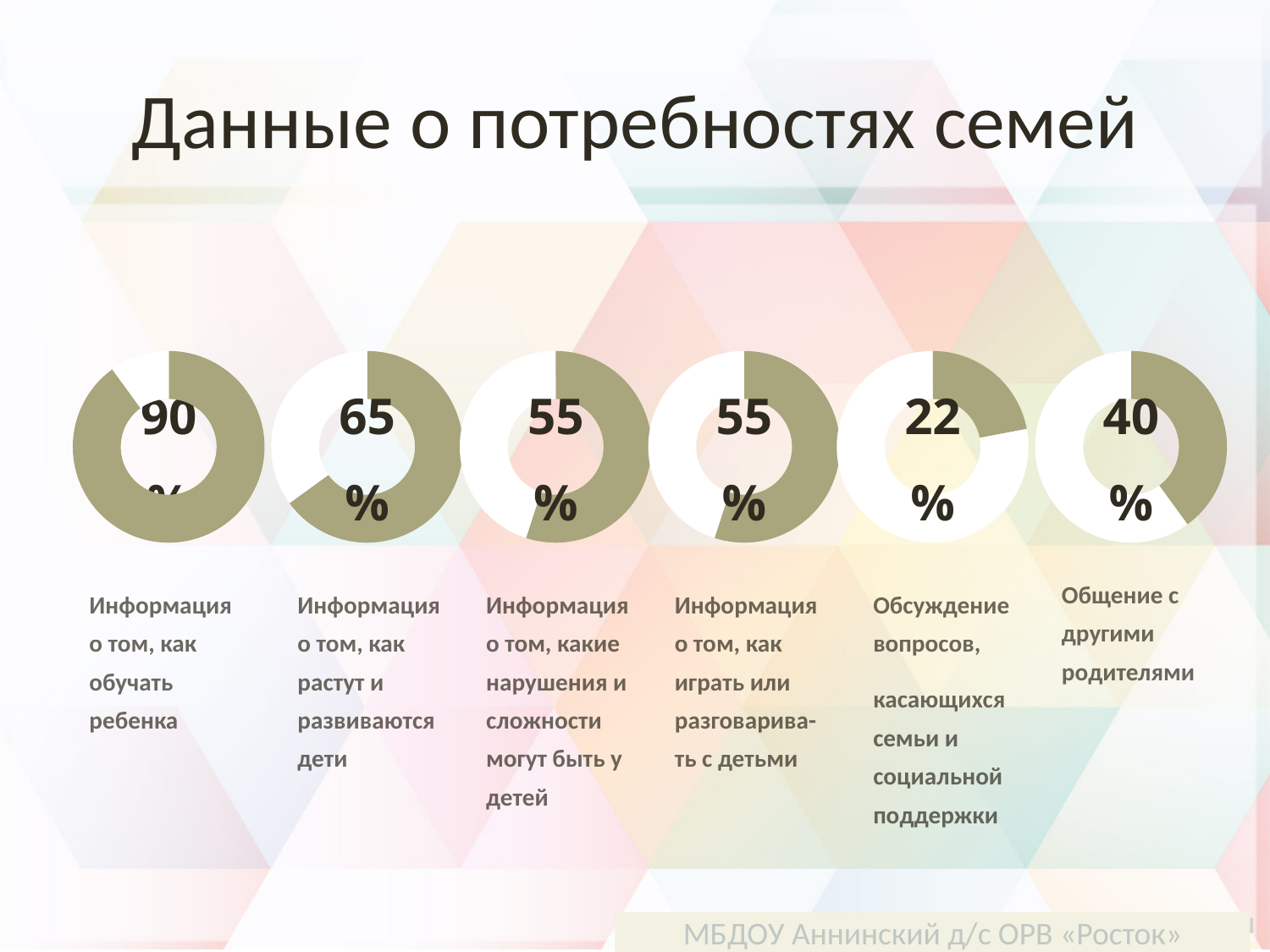
How many donut charts are shown on the slide? 6 What is the title of the slide containing the donut charts? Данные о потребностях семей Which need has the highest percentage among the donut charts on the slide? Информация о том, как обучать ребенка What percentage is shown on the donut chart for "Общение с другими родителями"? 40% What percentage is shown on the donut chart for "Информация о том, какие нарушения и сложности могут быть у детей"? 55% Which need has the lowest percentage among the donut charts on the slide? Обсуждение вопросов, касающихся семьи и социальной поддержки What percentage is shown on the donut chart for "Информация о том, как обучать ребенка"? 90% What kind of chart is used to show each percentage on the slide? Donut chart Which is larger: the percentage for "Информация о том, как растут и развиваются дети" or the percentage for "Информация о том, как играть или разговаривать с детьми"? Информация о том, как растут и развиваются дети What percentage is shown on the donut chart for "Информация о том, как растут и развиваются дети"? 65% What percentage is shown on the donut chart for "Обсуждение вопросов, касающихся семьи и социальной поддержки"? 22% What is the difference between the percentage for "Информация о том, как обучать ребенка" and the percentage for "Общение с другими родителями"? 50%